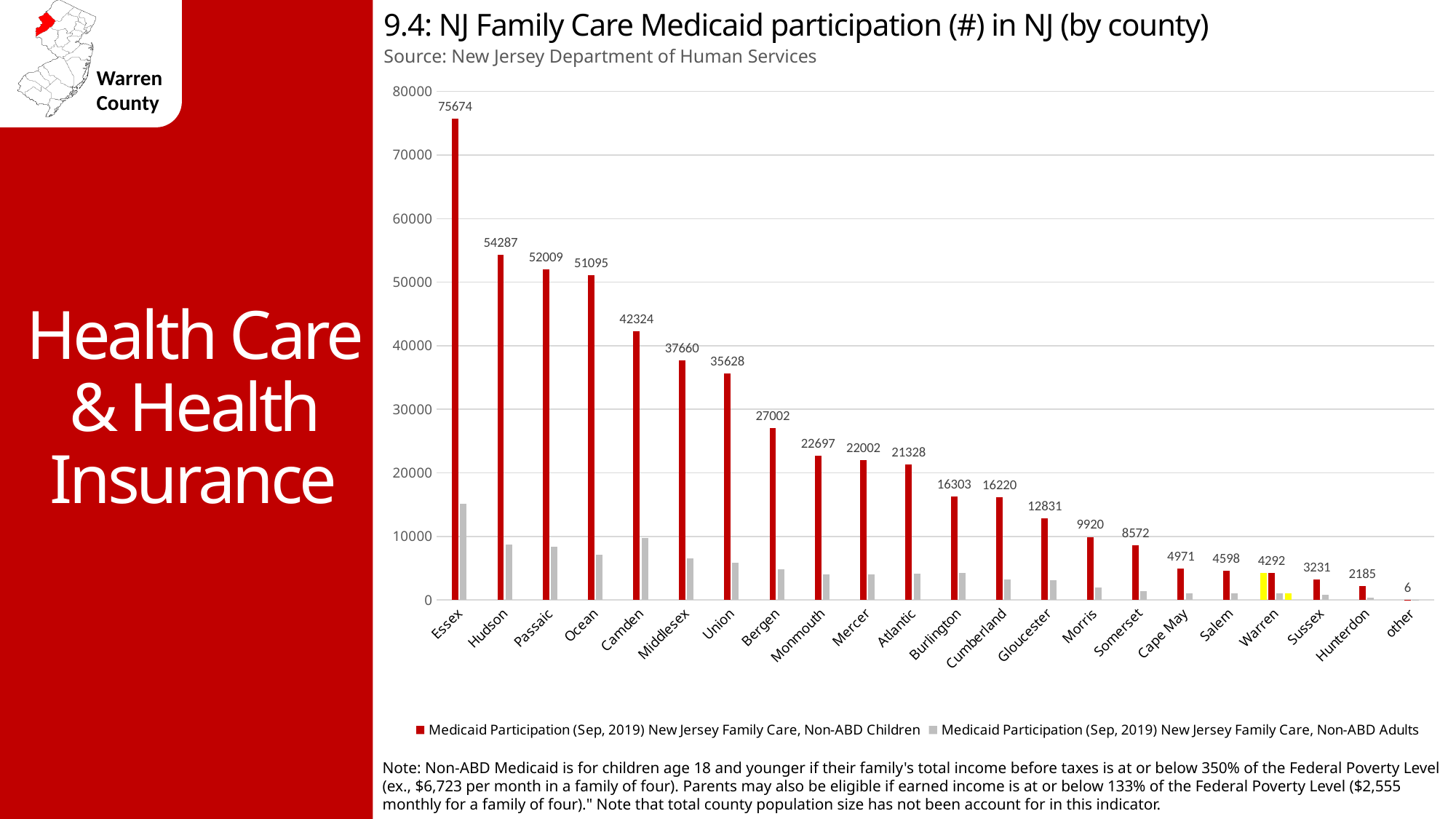
What is the difference between the Non-ABD Children values for Hudson and Passaic? 2278 Which county's bar is highlighted in yellow? Warren Is the Non-ABD Adults value for Essex greater or less than 10000? greater What is the Non-ABD Children Medicaid participation value for Warren County? 4292 Which has a larger Non-ABD Children value, Bergen or Monmouth? Bergen Which county (excluding 'other') has the lowest Non-ABD Children Medicaid participation? Hunterdon Which county has the highest Non-ABD Children Medicaid participation? Essex What kind of chart is shown on the slide? bar chart What is the Non-ABD Children Medicaid participation value for Essex County? 75674 How many series does the legend list? 2 What is the Non-ABD Children Medicaid participation value for Camden County? 42324 How many categories are shown on the x axis? 22